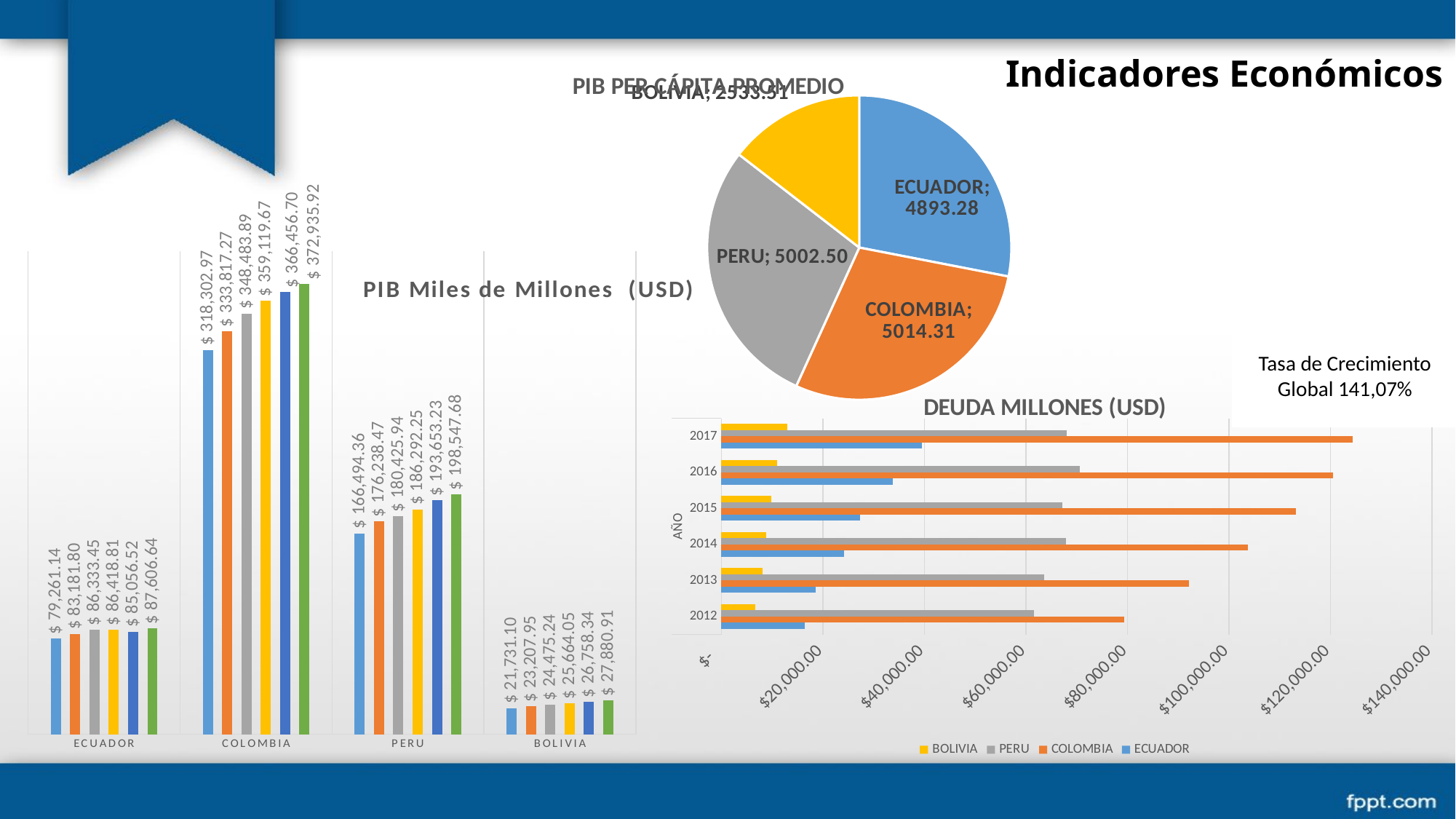
In the PIB Miles de Millones (USD) chart, which country has the lowest bars? Bolivia In the PIB Miles de Millones (USD) chart, which country has the highest bars? Colombia In the PIB PER CÁPITA PROMEDIO pie chart, what is the value for Ecuador? 4893.28 How many series does the legend of the DEUDA MILLONES (USD) chart list? 4 In the PIB PER CÁPITA PROMEDIO pie chart, what is the difference between the values for Colombia and Ecuador? 121.03 In the PIB PER CÁPITA PROMEDIO pie chart, which country has the smallest slice? Bolivia In the DEUDA MILLONES (USD) chart, does the value for Colombia rise or fall from 2012 to 2017? rise In the PIB Miles de Millones (USD) chart, what is the value of the tallest bar for Colombia? $ 372,935.92 In the PIB Miles de Millones (USD) chart, what is the difference between the tallest and shortest bars for Colombia? $ 54,632.95 In the DEUDA MILLONES (USD) chart, is the value for Colombia in 2017 greater or less than $100,000.00? greater How many years are shown on the DEUDA MILLONES (USD) chart? 6 In the PIB Miles de Millones (USD) chart, what is the value of the leftmost bar for Ecuador? $ 79,261.14